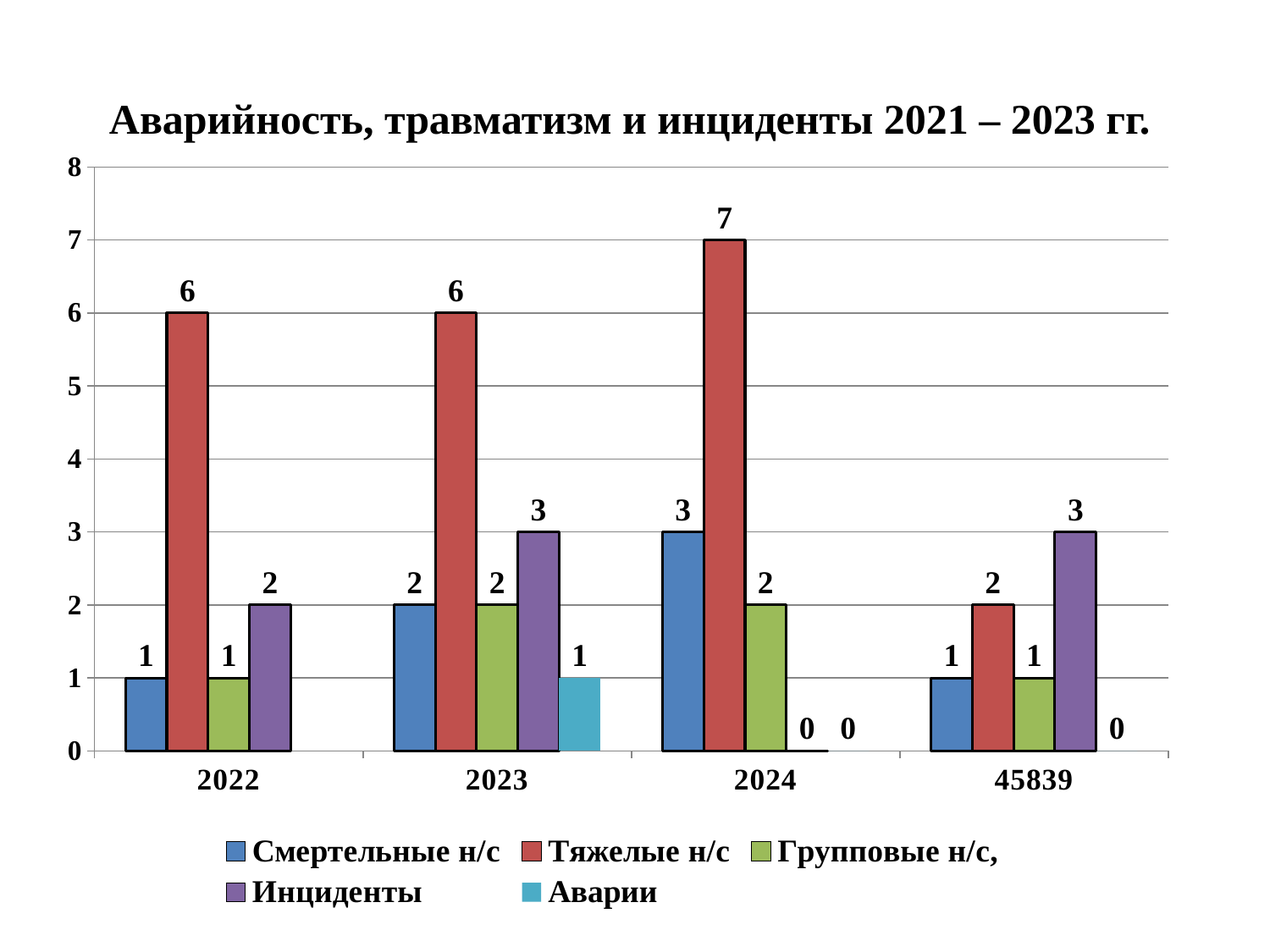
In which year is the value for Тяжелые н/с highest? 2024 What is the value for Инциденты in 2022? 2 How many categories are shown on the x axis? 4 What kind of chart is shown on the slide? Bar chart Which is larger: Инциденты in 2023 or Инциденты in 2022? Инциденты in 2023 How many series does the legend list? 5 What is the value for Смертельные н/с in 2023? 2 What is the value for Аварии in 2023? 1 What is the value for Тяжелые н/с in 2024? 7 In which category is the value for Смертельные н/с highest? 2024 What is the difference between Тяжелые н/с in 2024 and Тяжелые н/с in 45839? 5 What is the title of the chart? Аварийность, травматизм и инциденты 2021 – 2023 гг.